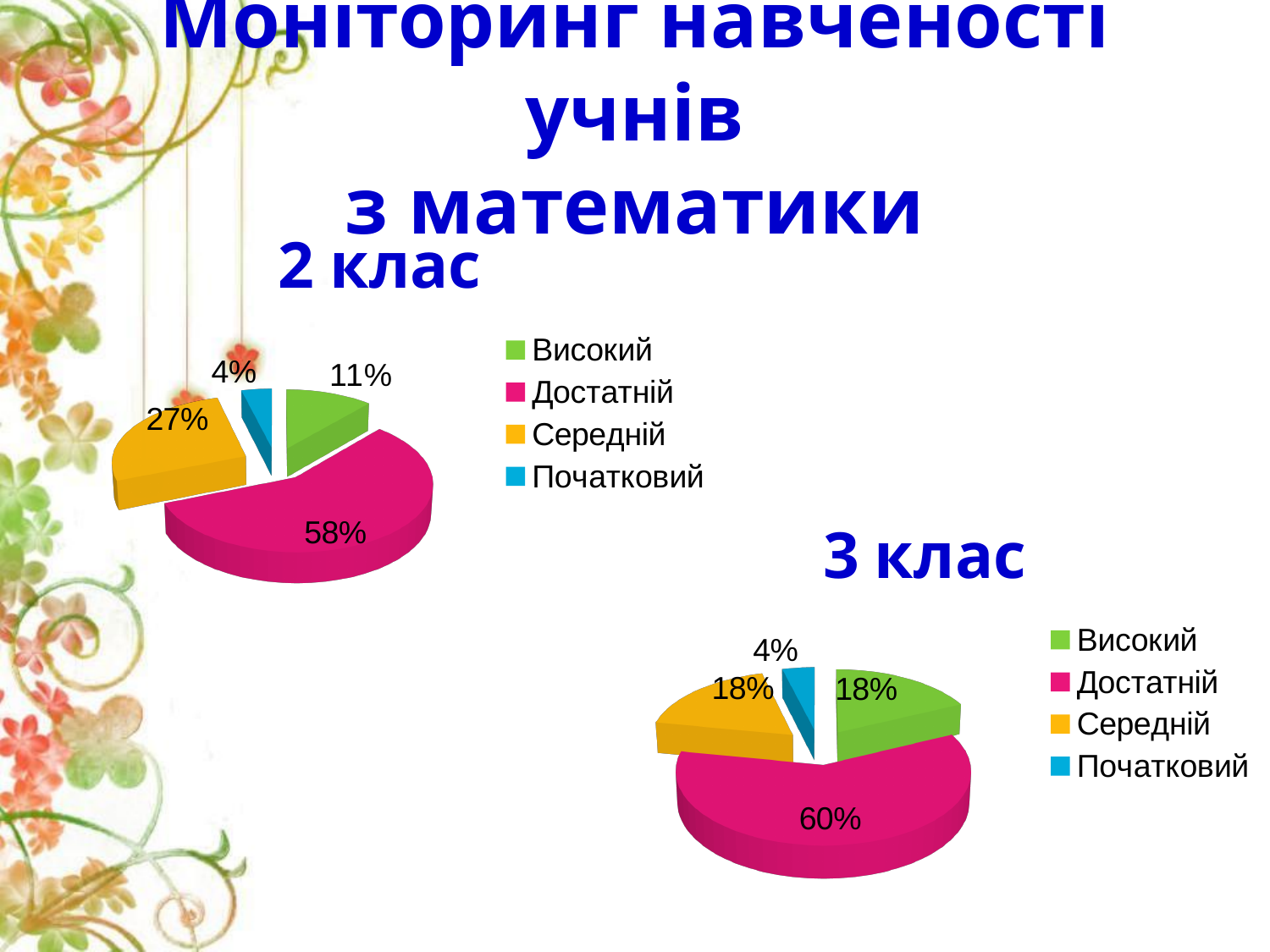
Which is larger: the share of Високий in the "2 клас" chart or in the "3 клас" chart? 3 клас In the "2 клас" chart, what share does Середній have? 27% In the "2 клас" chart, which category has the largest share? Достатній In the "2 клас" chart, which category has the smallest share? Початковий How many categories does the legend of the "3 клас" chart list? 4 In the "3 клас" chart, what share does Достатній have? 60% In the "2 клас" chart, what share does Достатній have? 58% What type of chart is the "2 клас" chart? Pie chart In the "3 клас" chart, what is the difference between the shares of Високий and Початковий? 14% In the "3 клас" chart, which category has the largest share? Достатній In the "3 клас" chart, what share does Початковий have? 4% In the "2 клас" chart, what is the difference between the shares of Достатній and Середній? 31%